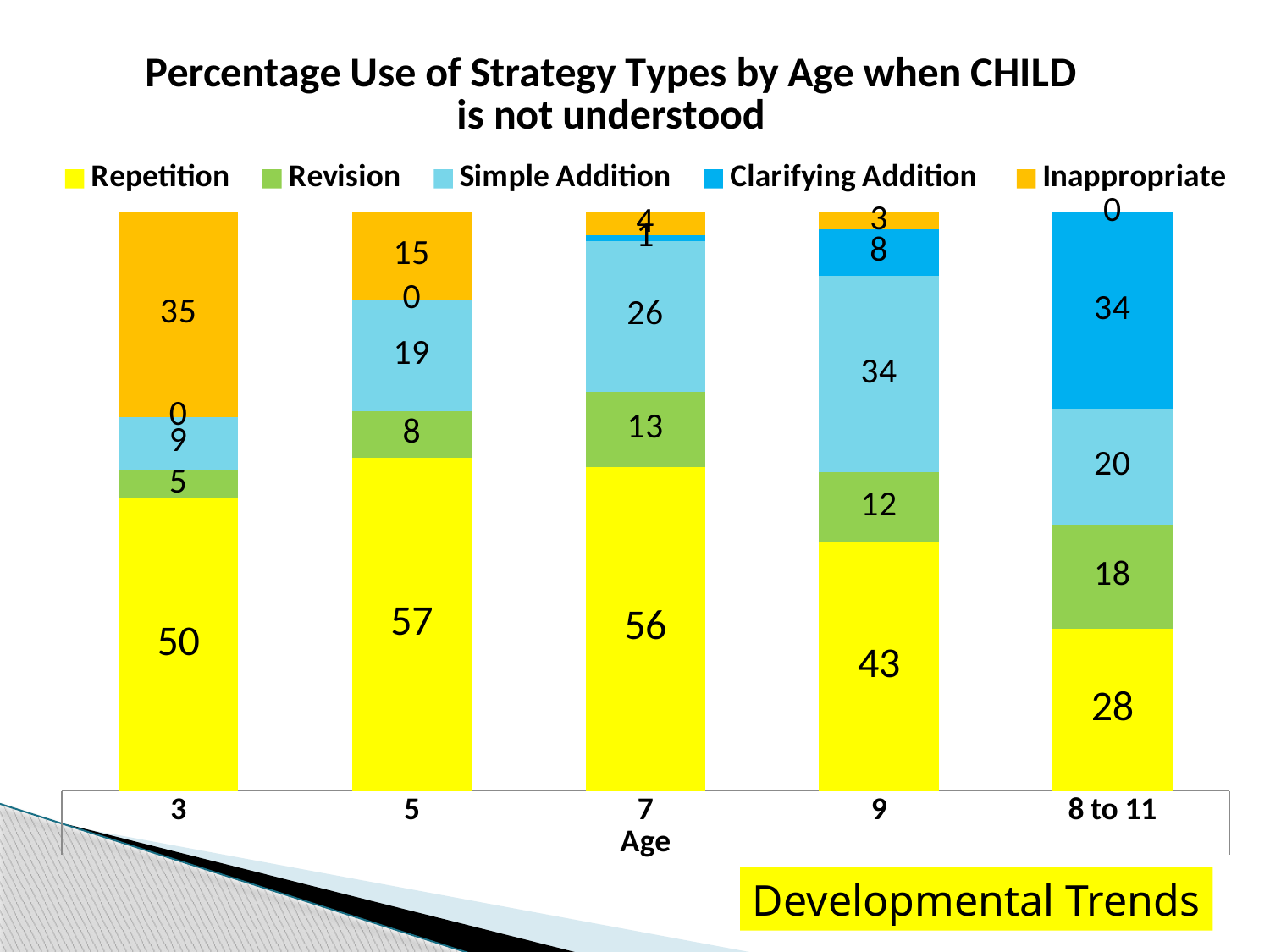
What is the difference between the Inappropriate values for age 3 and age 5? 20 What type of chart is shown on the slide? Stacked bar chart Which is larger, the Revision value for age 7 or the Revision value for age 9? Age 7 How many age categories are shown on the x axis? 5 What is the Inappropriate value for age 5? 15 What is the Simple Addition value for age 9? 34 Which age category has the lowest Repetition value? 8 to 11 What is the total of the stacked bar for age 7? 100 What is the Clarifying Addition value for the 8 to 11 age group? 34 What is the Repetition value for age 3? 50 Which age category has the highest Repetition value? 5 How many series does the legend list? 5